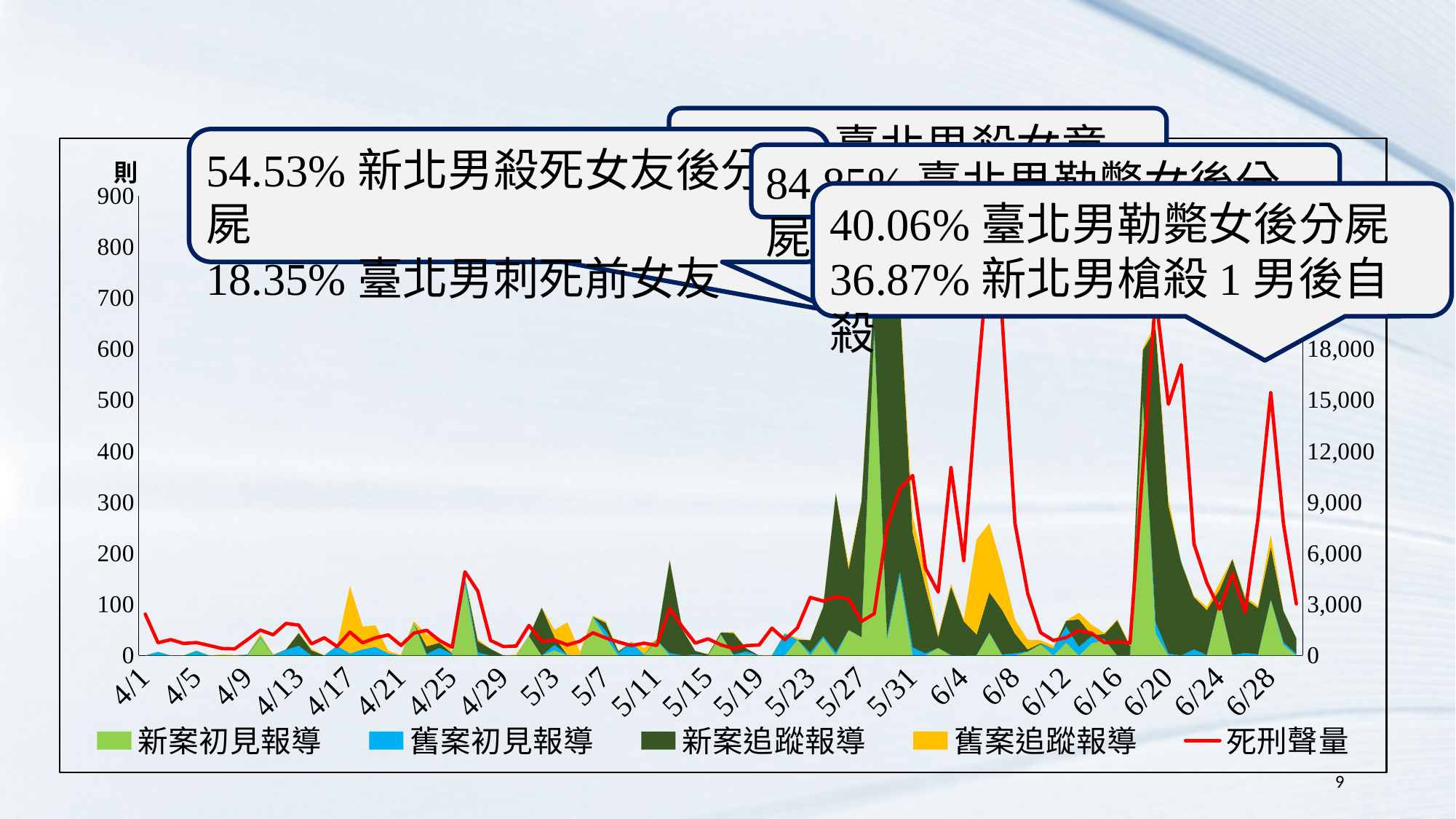
Is the stacked total of the area series at the 6/20 peak greater or less than 500? greater How many series does the legend list? 5 What is the first date label on the x axis? 4/1 How many date labels are shown on the x axis? 23 Is the stacked total of the area series at the 5/27 peak greater or less than 600? greater What kind of chart is used to plot the 死刑聲量 series? line Is the peak 死刑聲量 value near 6/28 greater or less than 12,000? greater What unit label is shown above the left-hand axis? 則 What is the highest tick value on the left-hand axis? 900 What is the last date label on the x axis? 6/28